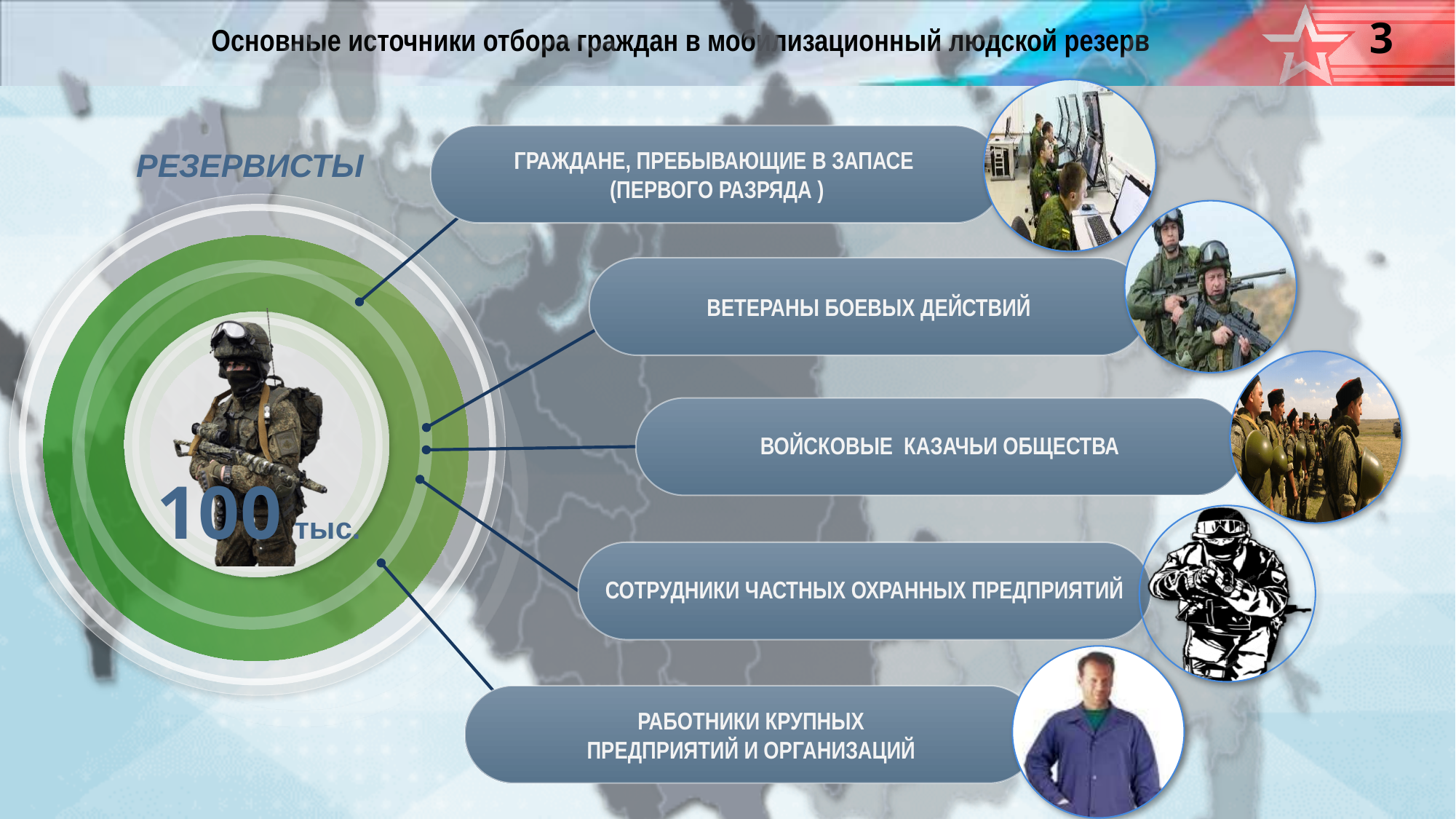
What label appears above the circular diagram on the left? РЕЗЕРВИСТЫ Which source is listed last (at the bottom) in the diagram? РАБОТНИКИ КРУПНЫХ ПРЕДПРИЯТИЙ И ОРГАНИЗАЦИЙ Which source is listed third in the diagram? ВОЙСКОВЫЕ КАЗАЧЬИ ОБЩЕСТВА What is the title of the slide? Основные источники отбора граждан в мобилизационный людской резерв What number is shown in the centre of the circular diagram? 100 тыс. Which source is listed first (at the top) in the diagram? ГРАЖДАНЕ, ПРЕБЫВАЮЩИЕ В ЗАПАСЕ (ПЕРВОГО РАЗРЯДА) How many sources of selection are listed in the diagram? 5